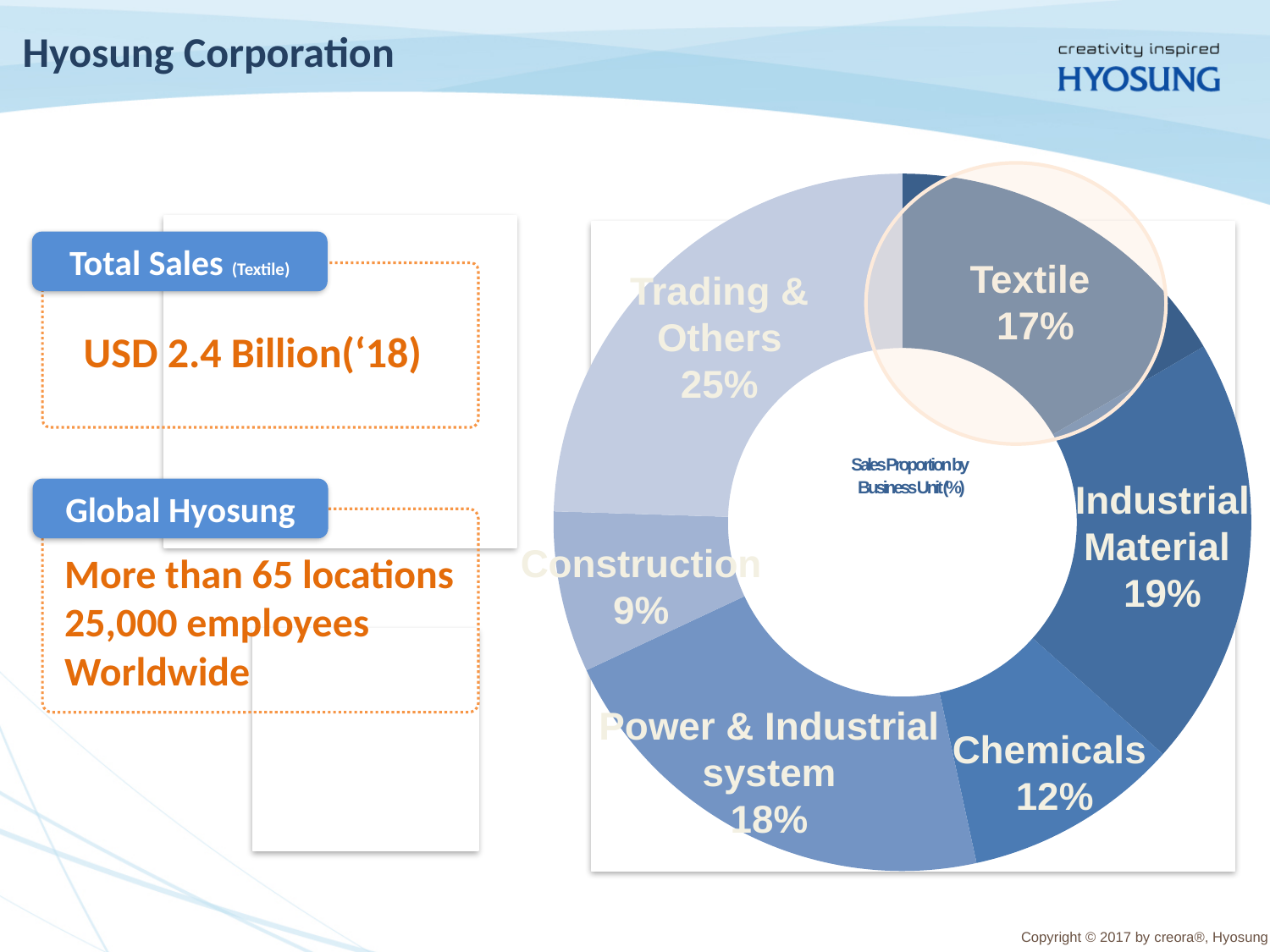
What is the sales proportion for Construction? 9% What percentage of sales comes from Industrial Material? 19% What is the title shown in the centre of the chart? Sales Proportion by Business Unit(%) Which has a larger share of sales, Industrial Material or Chemicals? Industrial Material How many percentage points larger is the Trading & Others share than the Textile share? 8 What kind of chart is used to show the sales proportion by business unit? Doughnut (pie) chart Which business unit has the smallest share of sales? Construction What share of sales does Textile account for in the Sales Proportion by Business Unit chart? 17% Which business unit has the largest share of sales? Trading & Others What is the sales proportion for Chemicals? 12% What share of sales does Power & Industrial system represent? 18% How many business units are shown in the chart? 6